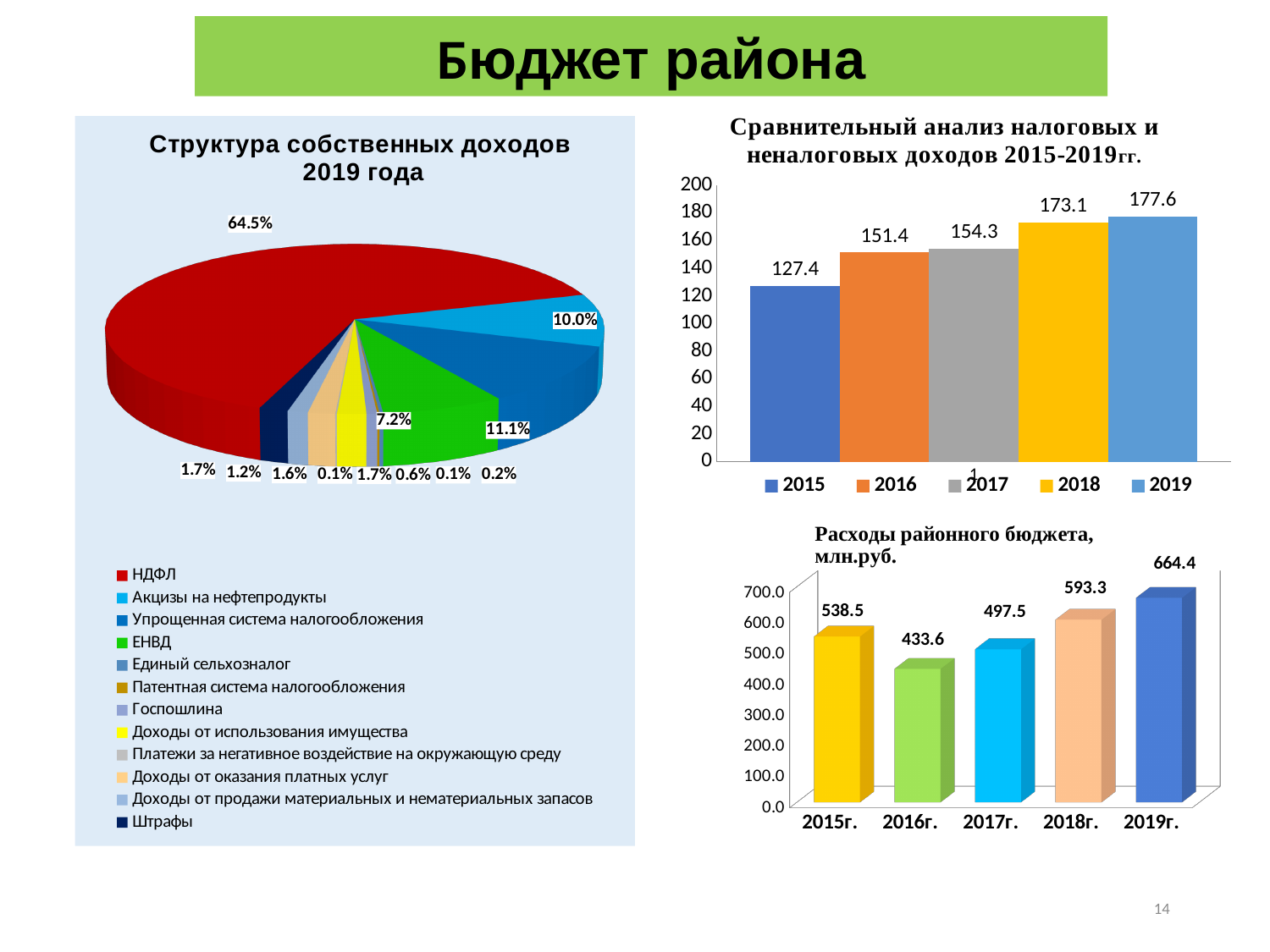
In the chart 'Сравнительный анализ налоговых и неналоговых доходов 2015-2019гг.', what is the value for 2015? 127.4 What kind of chart is 'Структура собственных доходов 2019 года'? pie chart In the chart 'Сравнительный анализ налоговых и неналоговых доходов 2015-2019гг.', what is the difference between the 2019 and 2015 values? 50.2 In the chart 'Расходы районного бюджета, млн.руб.', what is the value for 2017г.? 497.5 In the chart 'Сравнительный анализ налоговых и неналоговых доходов 2015-2019гг.', do the values rise or fall from 2015 to 2019? rise In the chart 'Сравнительный анализ налоговых и неналоговых доходов 2015-2019гг.', which year has the highest value? 2019 In the chart 'Расходы районного бюджета, млн.руб.', which year has the lowest value? 2016г. In the chart 'Расходы районного бюджета, млн.руб.', which is larger: the value for 2015г. or the value for 2017г.? 2015г. In the pie chart 'Структура собственных доходов 2019 года', what share does НДФЛ have? 64.5% In the chart 'Расходы районного бюджета, млн.руб.', what is the difference between the 2019г. and 2018г. values? 71.1 In the chart 'Расходы районного бюджета, млн.руб.', how many years are shown? 5 In the chart 'Сравнительный анализ налоговых и неналоговых доходов 2015-2019гг.', what is the value for 2018? 173.1